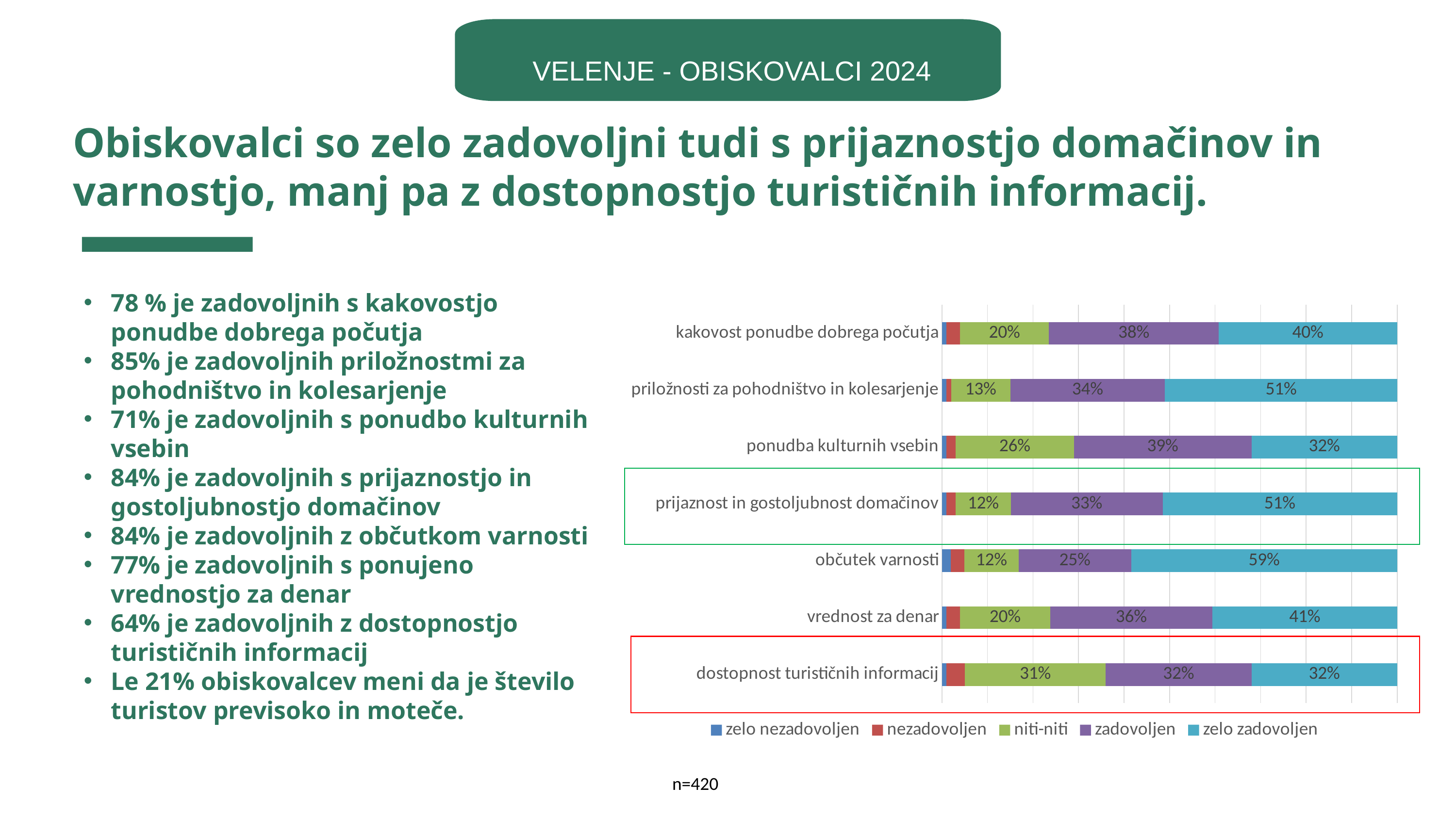
How many series does the legend list? 5 Which category has the highest 'niti-niti' value? dostopnost turističnih informacij Which category has the highest 'zelo zadovoljen' value? občutek varnosti Which has a larger 'zelo zadovoljen' value: 'priložnosti za pohodništvo in kolesarjenje' or 'vrednost za denar'? priložnosti za pohodništvo in kolesarjenje What is the value of the 'niti-niti' segment for 'dostopnost turističnih informacij'? 31% What is the value of the 'zadovoljen' segment for 'ponudba kulturnih vsebin'? 39% What is the difference between the 'zelo zadovoljen' values for 'občutek varnosti' and 'kakovost ponudbe dobrega počutja'? 19 percentage points How many categories are shown in the chart? 7 What kind of chart is shown on the slide? Stacked bar chart Which category has the lowest 'zadovoljen' value? občutek varnosti What is the first entry in the chart legend? zelo nezadovoljen What is the value of the 'zelo zadovoljen' segment for 'občutek varnosti'? 59%